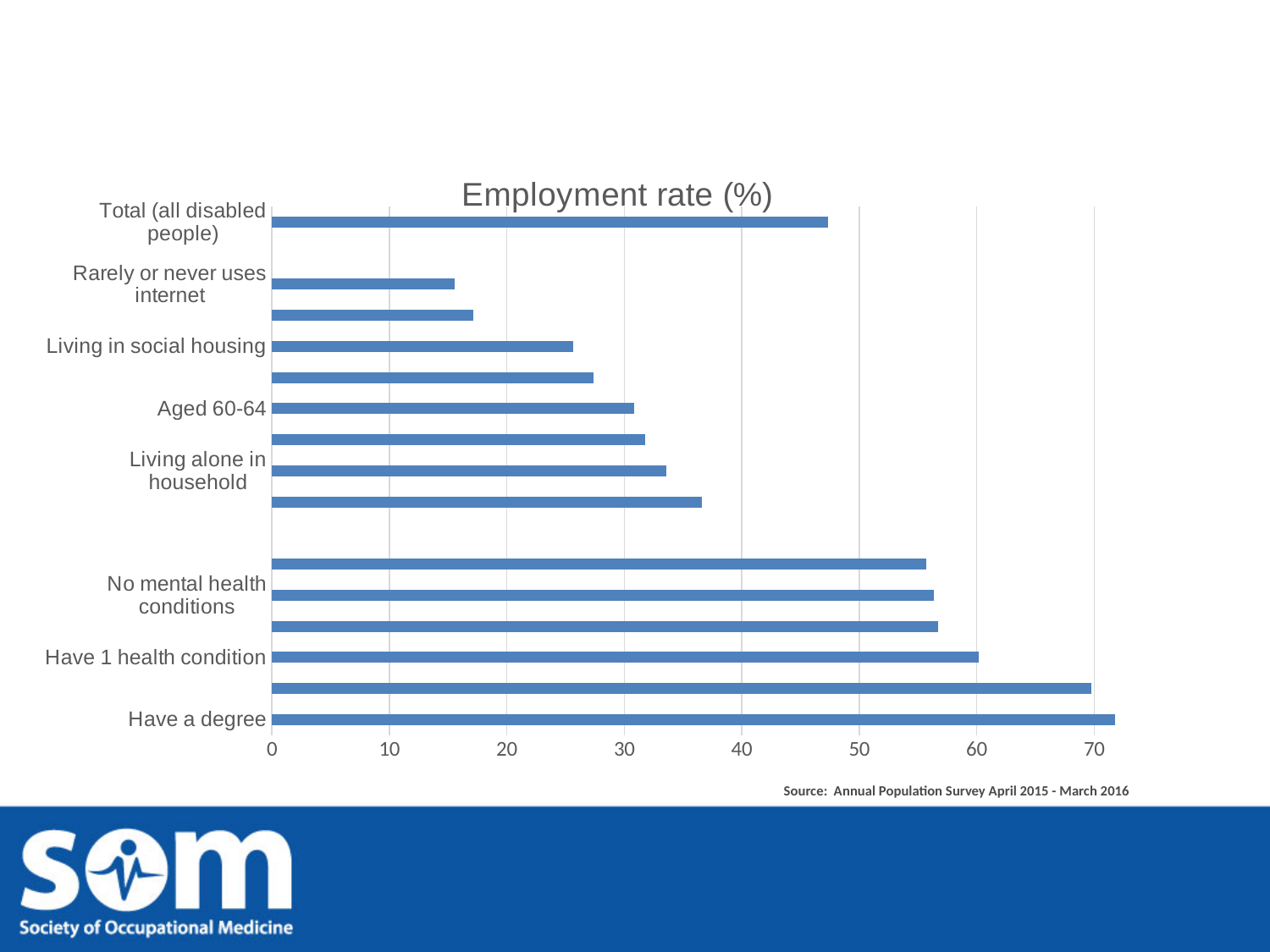
Is the value for No mental health conditions greater or less than 50? greater Which is larger, the employment rate for Aged 60-64 or for Living in social housing? Aged 60-64 Which labelled category has the lowest employment rate? Rarely or never uses internet Is the value for Total (all disabled people) greater or less than 50? less What kind of chart is shown on the slide? Bar chart What is the title of the chart? Employment rate (%) Which labelled category has the highest employment rate? Have a degree Is the value for Total (all disabled people) greater or less than 40? greater Which is larger, the employment rate for Have a degree or for Total (all disabled people)? Have a degree